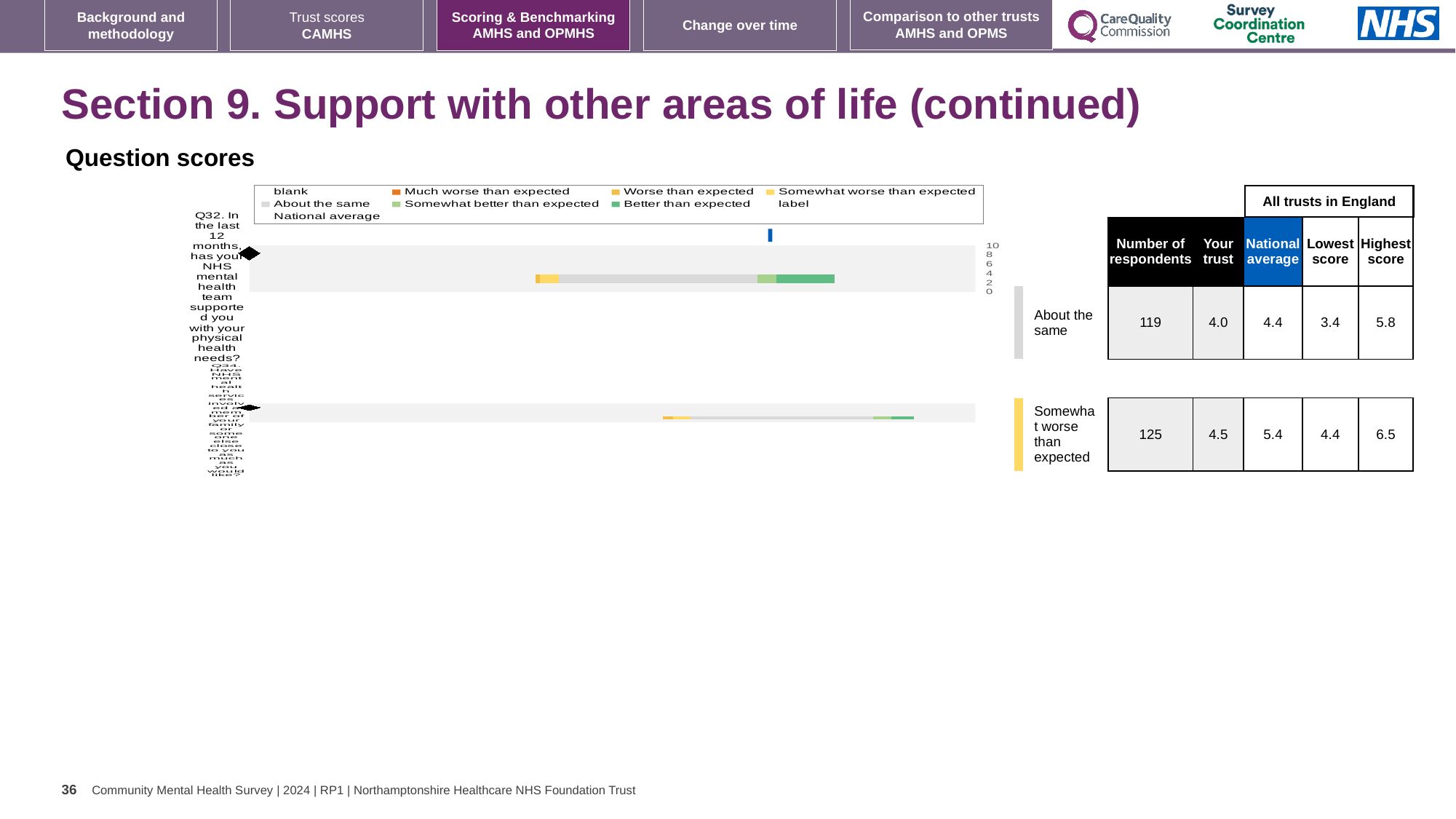
According to the table beside the chart, how many respondents answered Q34? 125 How many entries does the legend of the question scores chart list? 9 According to the table beside the chart, what is the national average for Q34? 5.4 What kind of chart is used to show the question scores on this slide? bar chart In the question scores chart legend, what colour represents 'Better than expected'? green Is the 'Your trust' score for Q32 greater or less than the national average for Q32? less What benchmark category is shown for Q34 next to the chart? Somewhat worse than expected According to the table beside the chart, what is the 'Your trust' score for Q32? 4.0 What is the difference between the highest score and the lowest score for Q32 in the table beside the chart? 2.4 How many questions (categories) are plotted in the question scores chart? 2 What is the highest tick value shown on the axis of the question scores chart? 10 Which question has the higher 'Your trust' score in the table beside the chart, Q32 or Q34? Q34